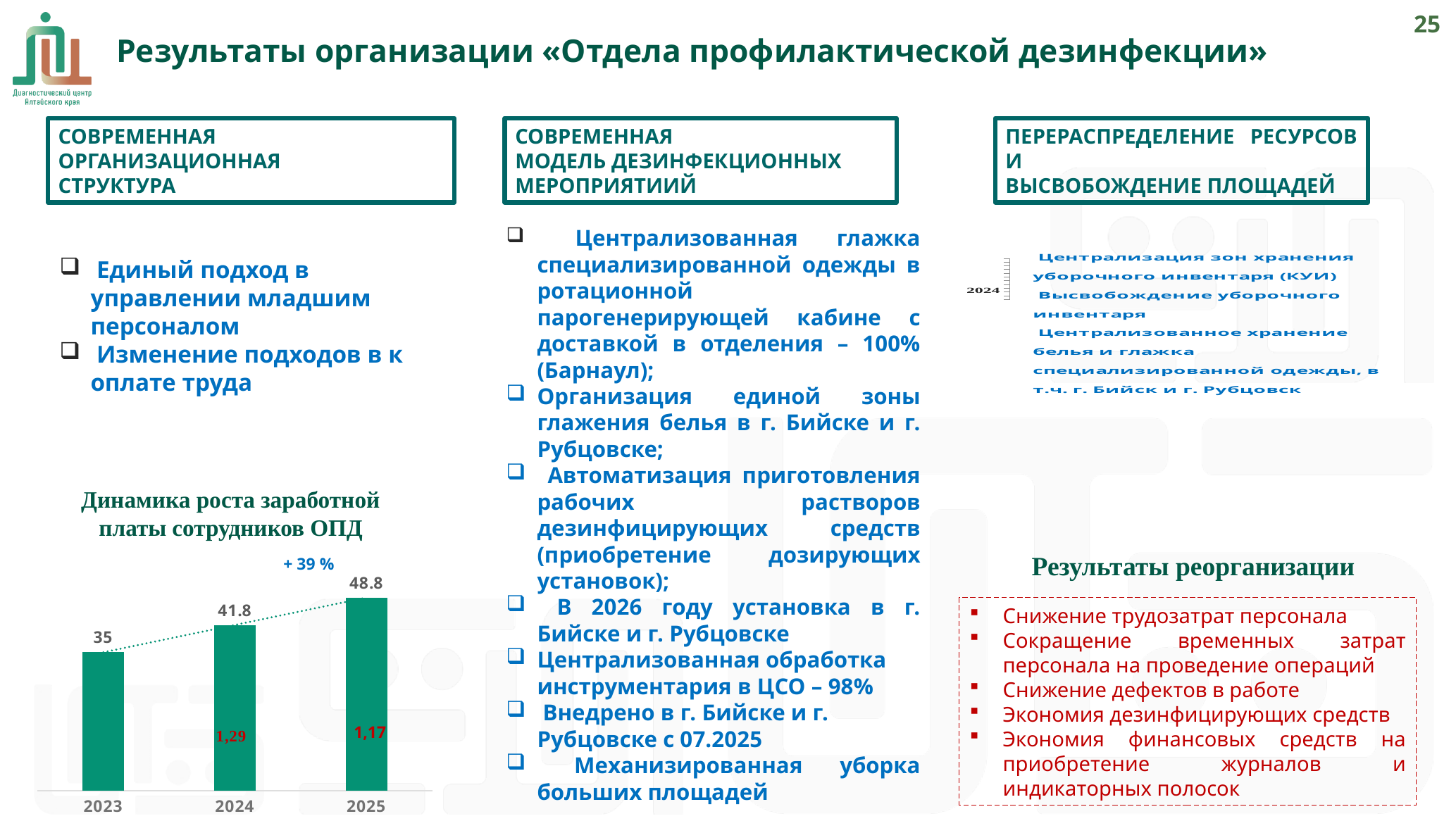
What is the value for 2024 in the chart 'Динамика роста заработной платы сотрудников ОПД'? 41.8 How many years (bars) are shown in the chart 'Динамика роста заработной платы сотрудников ОПД'? 3 In the chart 'Динамика роста заработной платы сотрудников ОПД', what is the difference between the values for 2025 and 2023? 13.8 Which year has the highest value in the chart 'Динамика роста заработной платы сотрудников ОПД'? 2025 What type of chart is 'Динамика роста заработной платы сотрудников ОПД'? Bar chart Do the values in the chart 'Динамика роста заработной платы сотрудников ОПД' rise or fall from 2023 to 2025? Rise What is the value for 2025 in the chart 'Динамика роста заработной платы сотрудников ОПД'? 48.8 In the chart 'Динамика роста заработной платы сотрудников ОПД', what is the difference between the values for 2024 and 2023? 6.8 In the chart 'Динамика роста заработной платы сотрудников ОПД', which is larger: the value for 2024 or the value for 2025? 2025 Which year has the lowest value in the chart 'Динамика роста заработной платы сотрудников ОПД'? 2023 What overall percentage growth is annotated above the bars in the chart 'Динамика роста заработной платы сотрудников ОПД'? + 39 % What is the value for 2023 in the chart 'Динамика роста заработной платы сотрудников ОПД'? 35